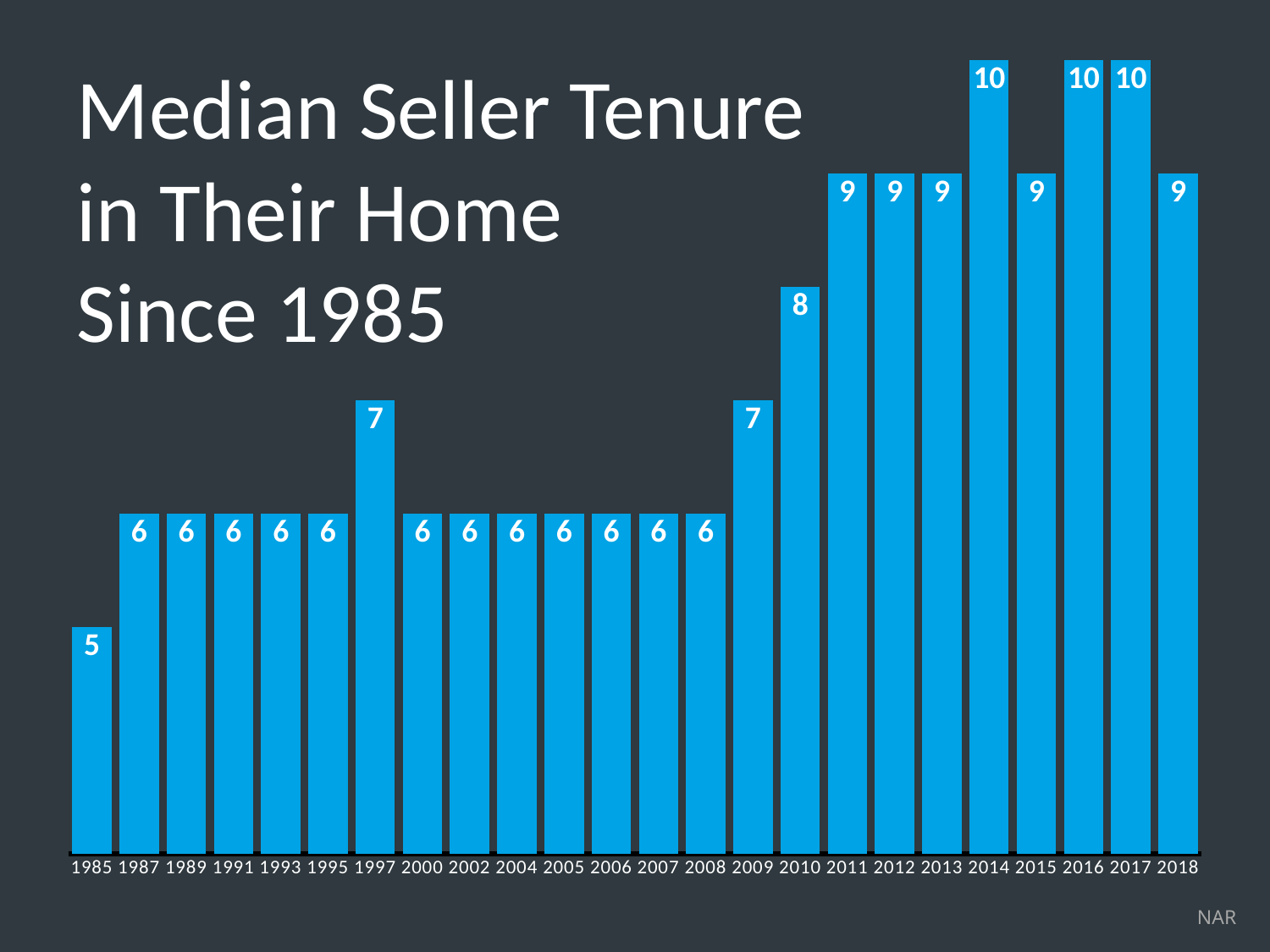
Do the values generally rise or fall from 1985 to 2018? Rise What value is shown for 1997? 7 How many years are shown on the x axis? 24 Which is larger, the value for 2009 or the value for 2011? 2011 What is the median seller tenure shown for 1985? 5 What is the difference between the values for 2018 and 1985? 4 What is the highest value shown on the chart? 10 What kind of chart is shown on the slide? Bar chart What value is shown for 2010? 8 What is the difference between the values for 2014 and 2010? 2 What value is shown for 2018? 9 Which year has the lowest median seller tenure? 1985